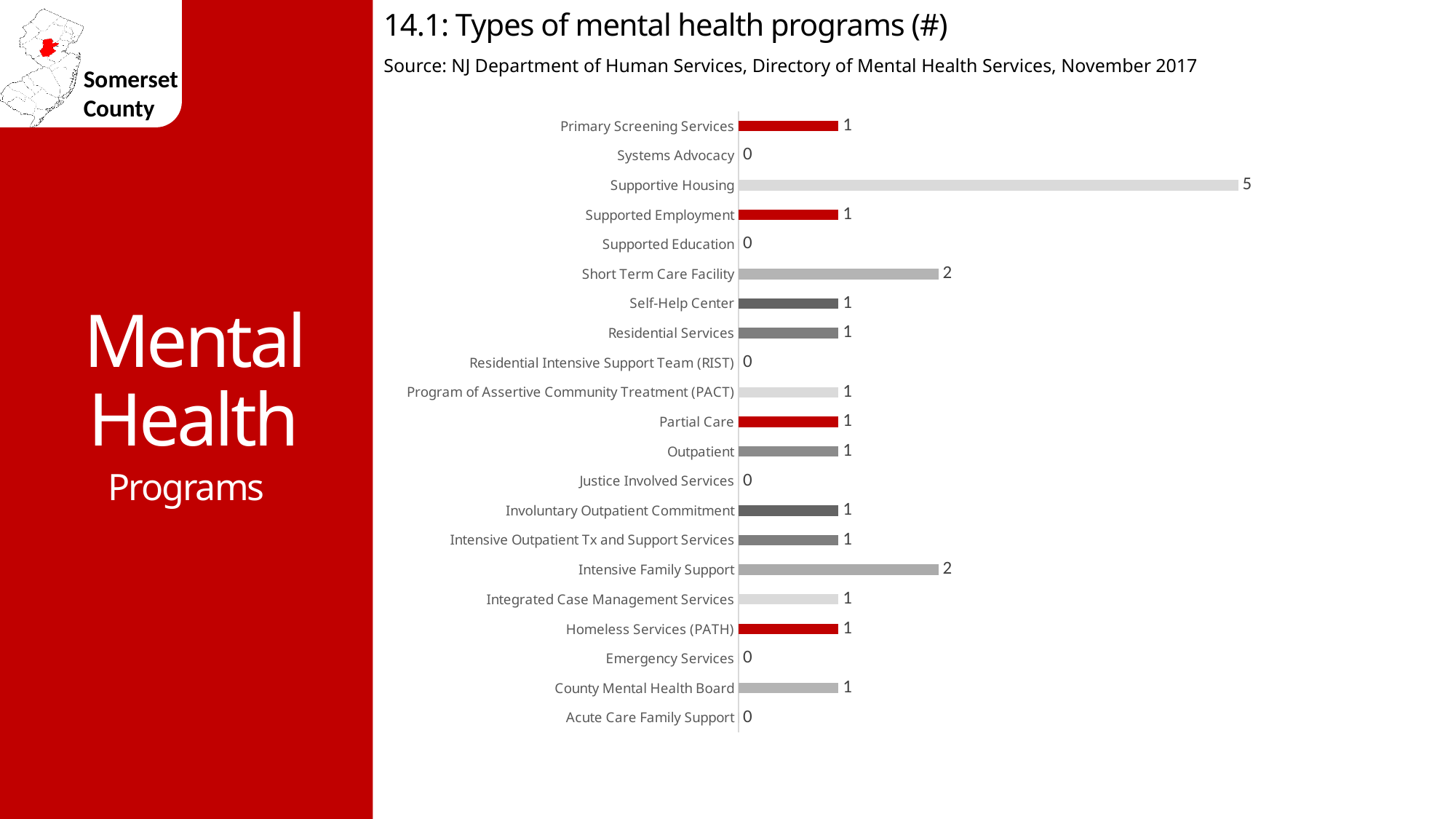
Which is larger, the value for Short Term Care Facility or the value for Self-Help Center? Short Term Care Facility Which category has the highest value? Supportive Housing How many categories have a value of 0? 6 What is the title of the chart? 14.1: Types of mental health programs (#) What is the source cited for the chart data? NJ Department of Human Services, Directory of Mental Health Services, November 2017 What kind of chart is shown on the slide? Bar chart What is the difference between the values for Supportive Housing and Intensive Family Support? 3 What is the value for Homeless Services (PATH)? 1 What is the value for Supportive Housing? 5 How many categories are shown in the chart? 21 What is the value for Emergency Services? 0 What is the value for Short Term Care Facility? 2